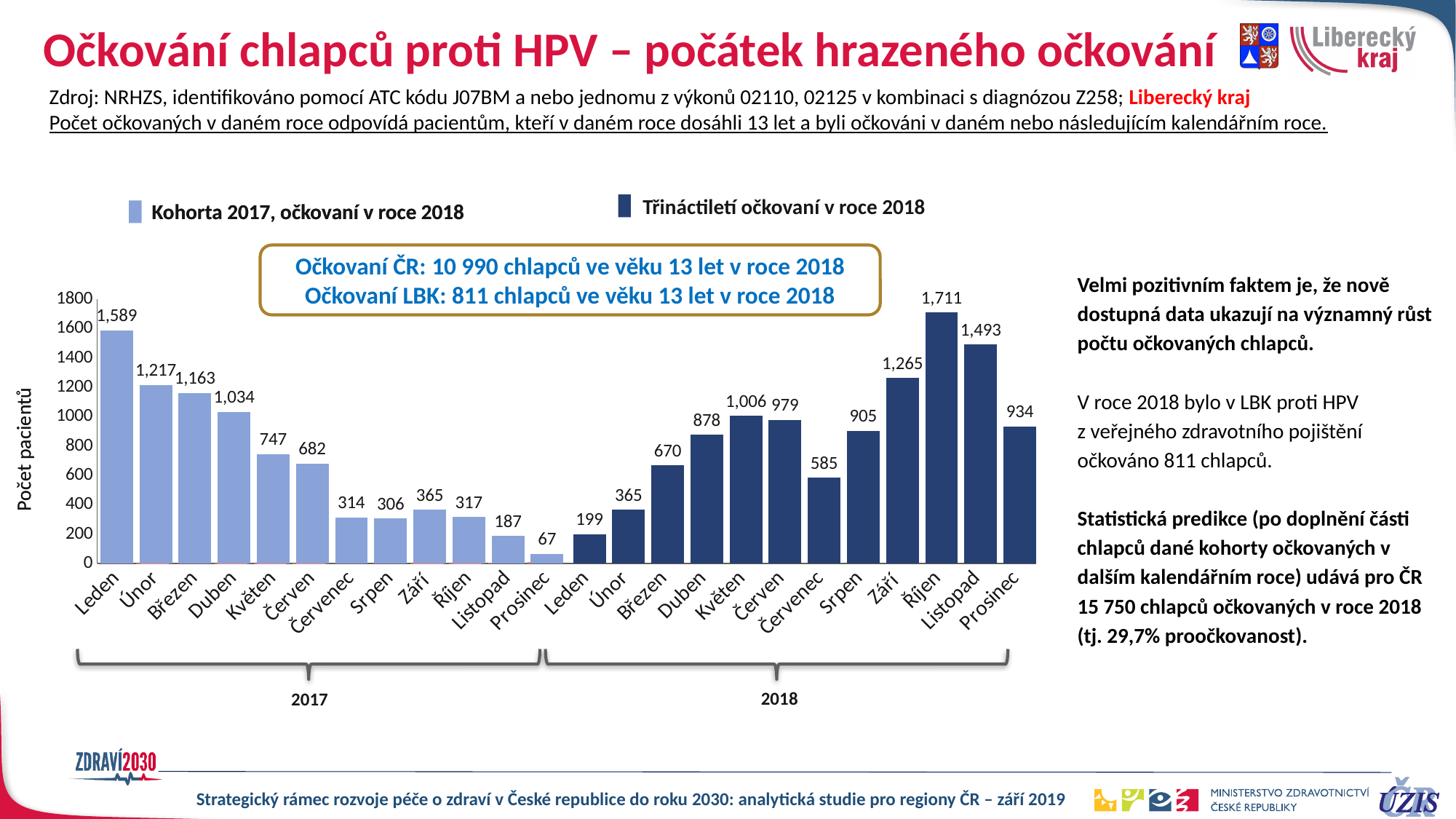
What is the value for Prosinec in 2017? 67 How many series does the legend list? 2 What is the value for Říjen in 2018 (Třináctiletí očkovaní v roce 2018 series)? 1,711 What is the difference between the values for Říjen 2018 and Listopad 2018? 218 Is the value for Duben 2017 greater or less than 1000? greater Which is larger: the value for Květen 2018 or the value for Červen 2018? Květen 2018 Which month in 2018 has the highest value? Říjen What kind of chart is shown on the slide? bar chart How many monthly bars are plotted in the chart in total? 24 Which month in 2017 has the lowest value? Prosinec Do the values for the 2017 months generally rise or fall from Leden to Prosinec? fall What is the value for Leden in 2017 (Kohorta 2017 series)? 1,589